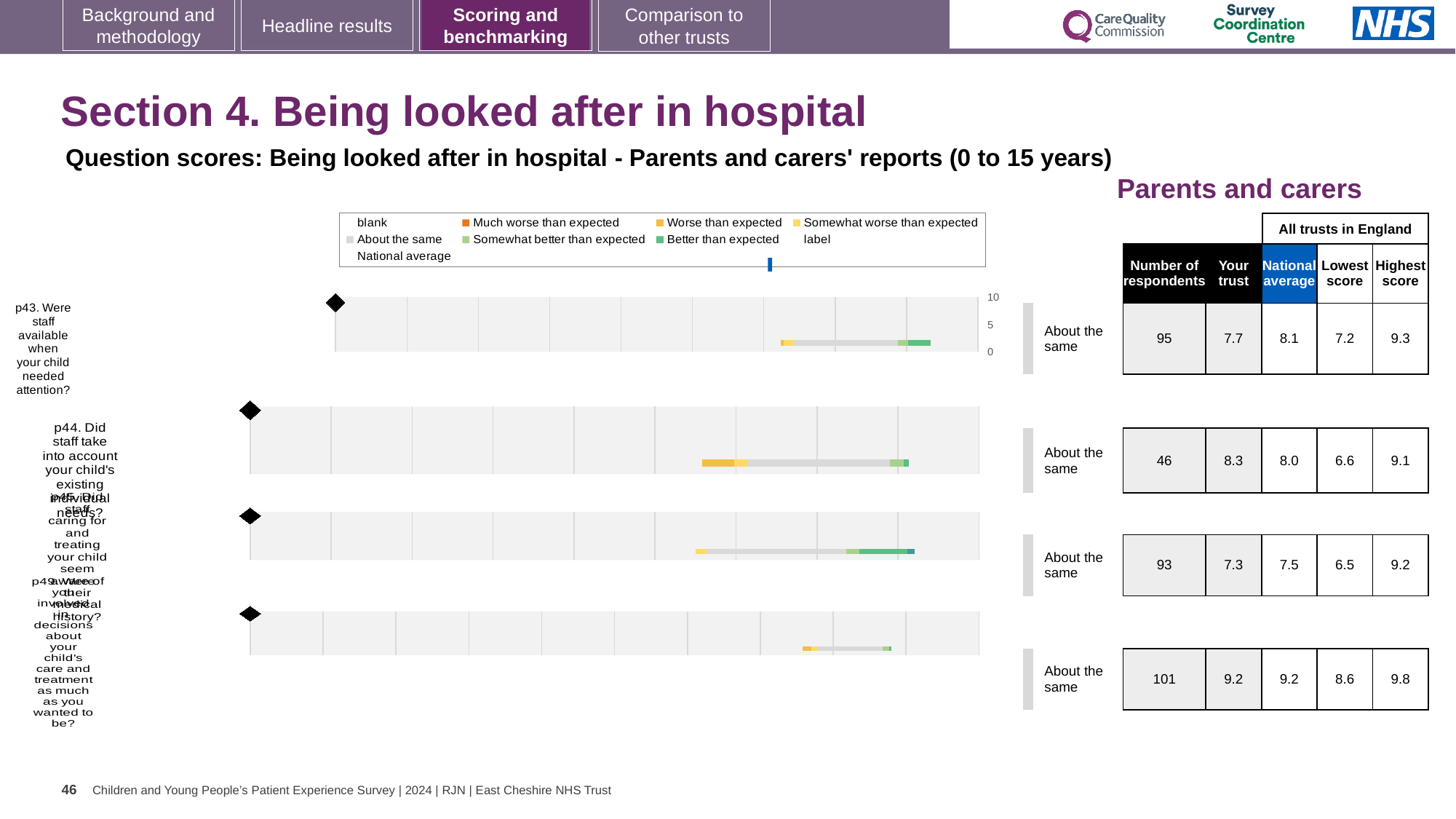
For question p43, what is the difference between the national average and the 'Your trust' score? 0.4 How many respondents are listed for question p49? 101 For question p44, which is larger: the 'Your trust' score or the national average? Your trust What kind of chart is used to show the question scores on this slide? bar chart What is the highest score among all trusts in England for question p45? 9.2 What benchmark category is shown next to each of the four questions? About the same Which question has the lowest 'Your trust' score? p45 How many questions (bars) are plotted in the chart? 4 What is the 'Your trust' score for question p43 (Were staff available when your child needed attention?)? 7.7 Which question has the highest 'Your trust' score? p49 What is the national average score for question p44? 8.0